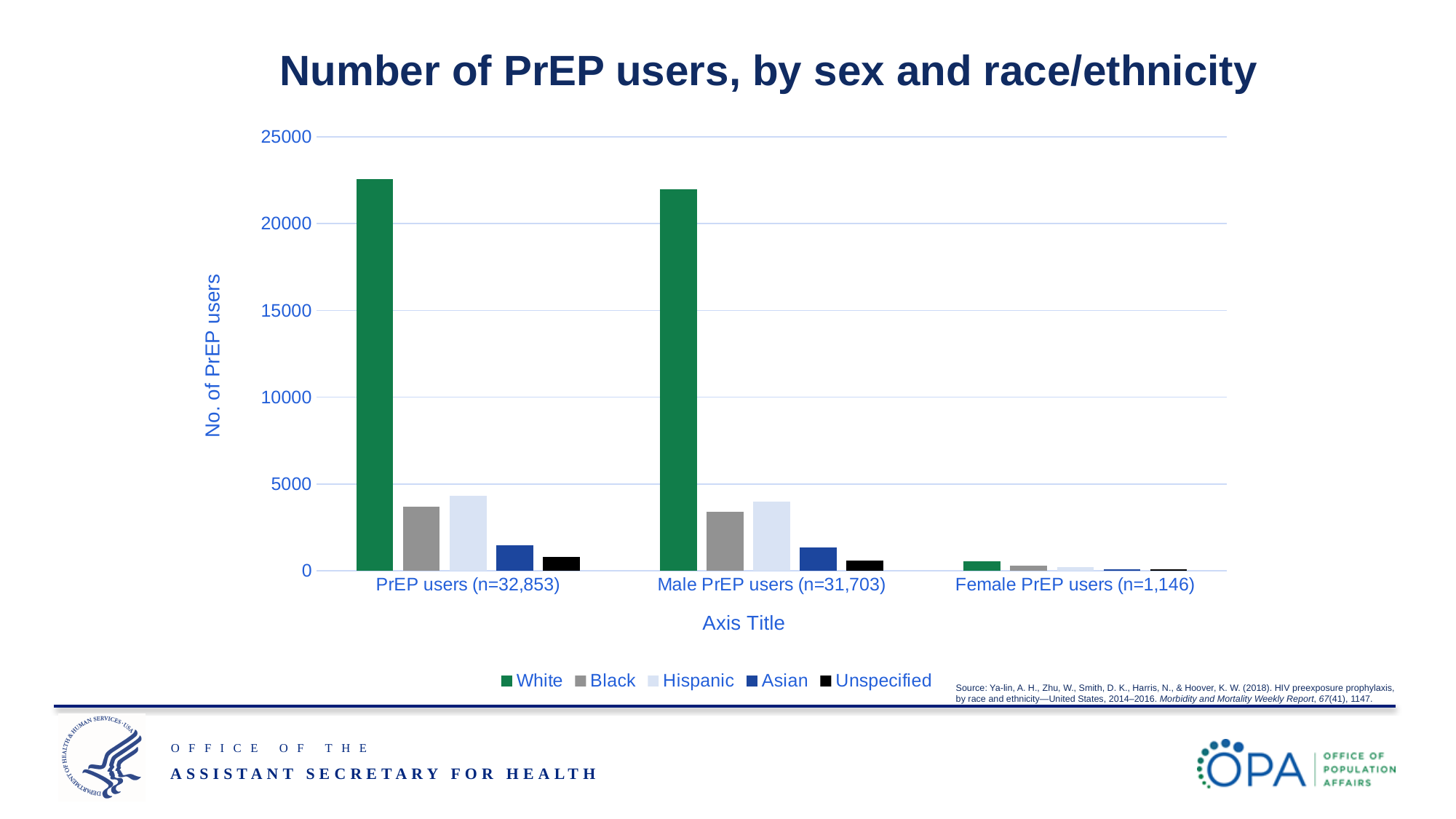
How many categories are shown on the x axis? 3 Is the Asian bar for 'PrEP users (n=32,853)' greater or less than 5000? less Which race/ethnicity has the lowest bar in the 'Male PrEP users (n=31,703)' group? Unspecified Which race/ethnicity has the highest number of PrEP users in the 'PrEP users (n=32,853)' group? White Is the Black bar for 'Male PrEP users (n=31,703)' greater or less than 5000? less What kind of chart is shown on the slide? bar chart What is the title of the chart? Number of PrEP users, by sex and race/ethnicity In the 'PrEP users (n=32,853)' group, which is larger: the Hispanic bar or the Black bar? Hispanic Is the White bar for 'Female PrEP users (n=1,146)' greater or less than 5000? less What is the label on the vertical axis? No. of PrEP users How many series does the legend list? 5